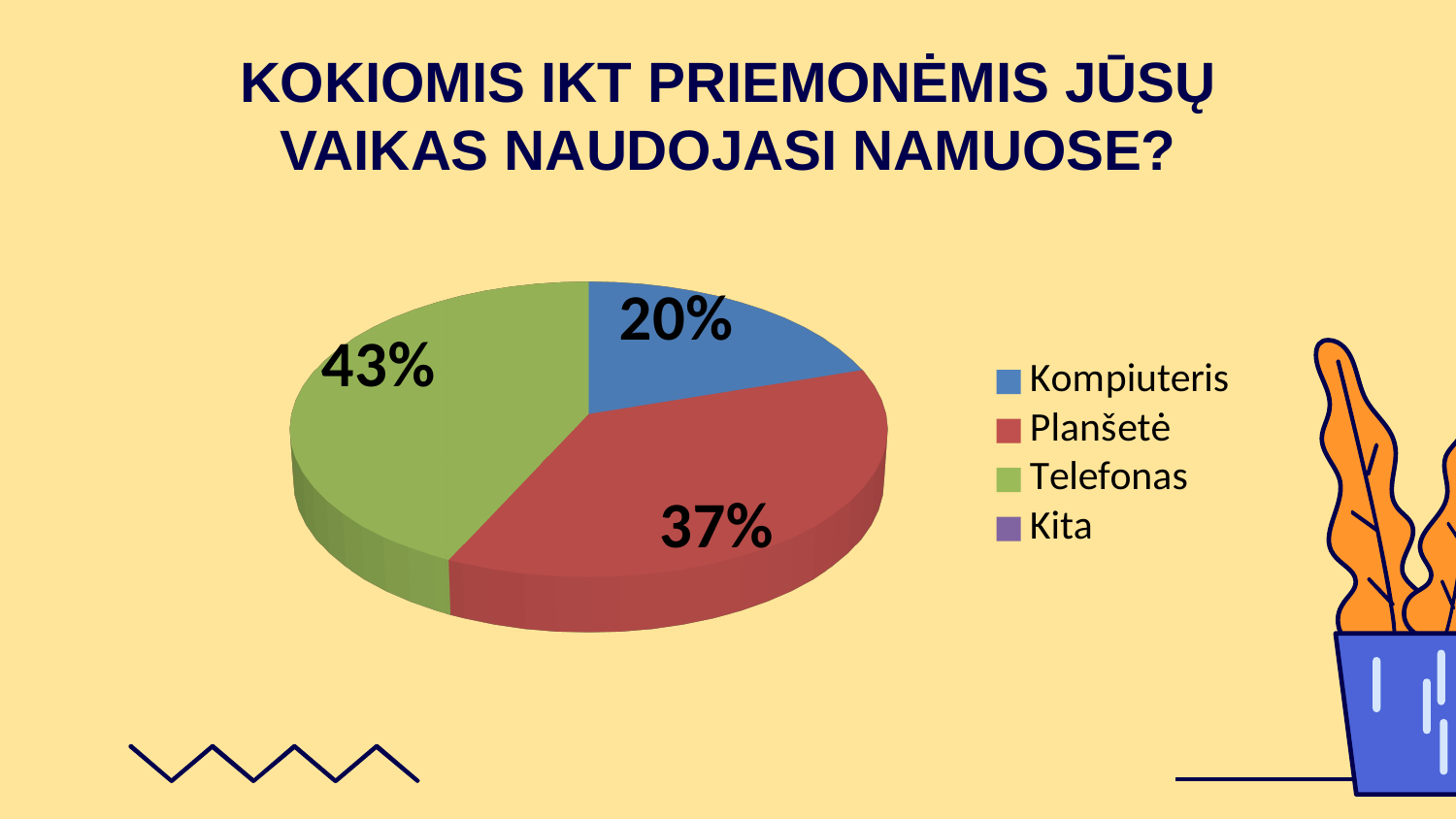
Which category has the largest slice of the pie? Telefonas How many entries does the legend list? 4 What is the difference in percentage points between Telefonas and Kompiuteris? 23 What kind of chart is shown on the slide? pie chart What colour is the Telefonas slice? green Which is larger, the share for Planšetė or the share for Kompiuteris? Planšetė What share of the pie does Planšetė have? 37% Which legend entry is shown in blue? Kompiuteris Which labelled slice is the smallest in the pie? Kompiuteris What share of the pie does Telefonas have? 43% What is the difference in percentage points between Telefonas and Planšetė? 6 What share of the pie does Kompiuteris have? 20%